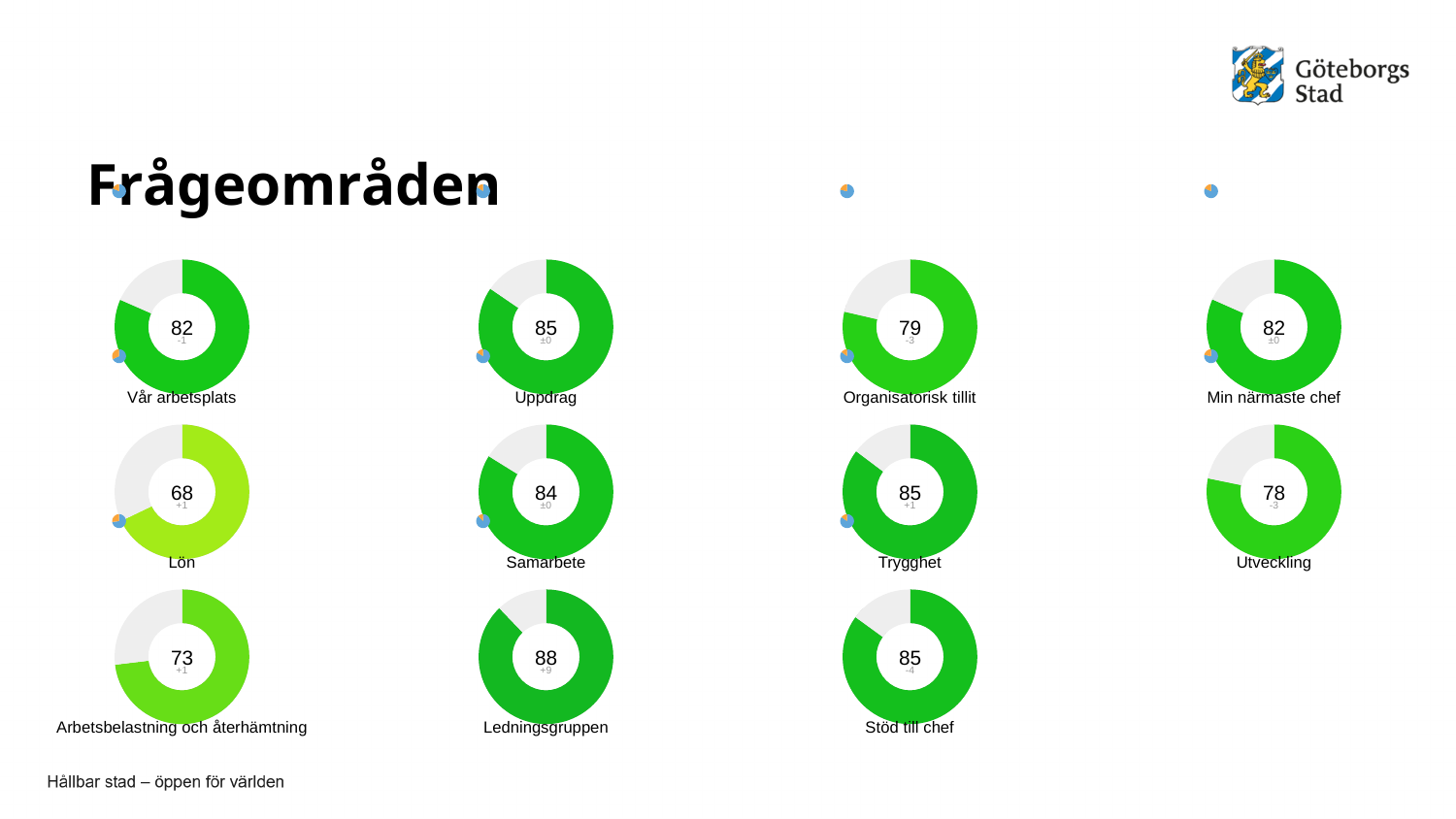
What value is shown in the centre of the 'Organisatorisk tillit' donut chart? 79 What value is shown in the centre of the 'Ledningsgruppen' donut chart? 88 How many donut charts are shown on the slide? 11 Which has the larger value, the 'Utveckling' chart or the 'Samarbete' chart? Samarbete Which donut chart on the slide shows the highest value? Ledningsgruppen What value is shown in the centre of the 'Vår arbetsplats' donut chart? 82 Which donut chart on the slide shows the lowest value? Lön What value is shown in the centre of the 'Lön' donut chart? 68 What is the title of the slide? Frågeområden What change value is printed under the main number in the 'Ledningsgruppen' donut chart? +9 What is the difference between the value in the 'Ledningsgruppen' chart and the value in the 'Lön' chart? 20 What kind of chart is used for each question area on the slide? Donut (pie) chart